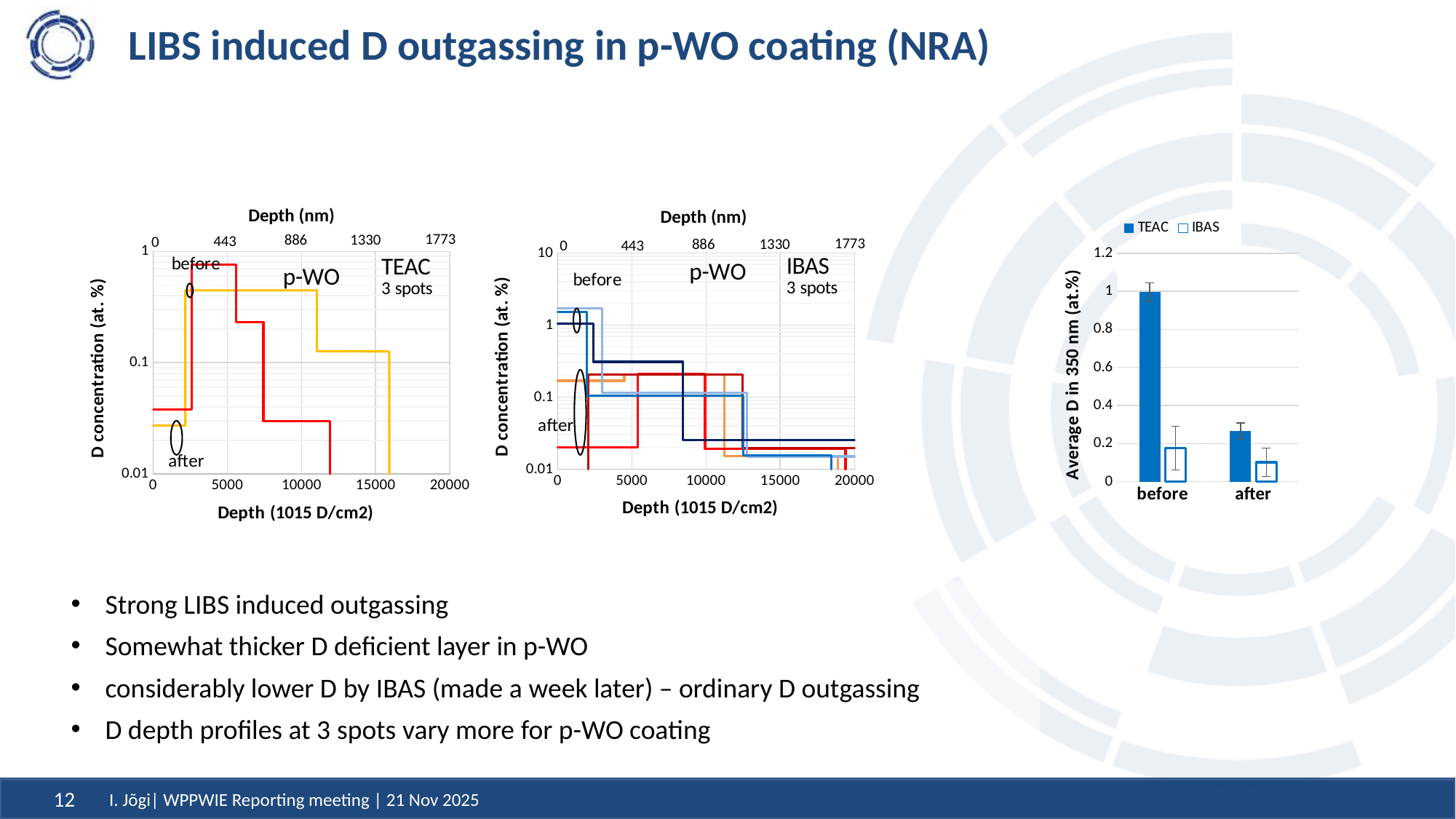
In the rightmost bar chart, does the TEAC value rise or fall from 'before' to 'after'? fall In the rightmost bar chart, which bar is the highest? TEAC before In the rightmost bar chart, is the IBAS value for 'before' greater or less than 0.4? less In the rightmost bar chart, which is larger for 'before': TEAC or IBAS? TEAC In the rightmost bar chart, is the TEAC value for 'after' greater or less than 0.4? less In the rightmost bar chart, how many series does the legend list? 2 What kind of chart is the rightmost chart on the slide (Average D in 350 nm)? bar chart In the rightmost bar chart, how many categories are shown on the x axis? 2 In the rightmost bar chart, is the TEAC value for 'before' greater or less than 0.8? greater In the rightmost bar chart, which bar is the lowest? IBAS after What is the y-axis label of the rightmost bar chart? Average D in 350 nm (at.%) What is the largest tick value on the top 'Depth (nm)' axis of the leftmost chart (TEAC)? 1773